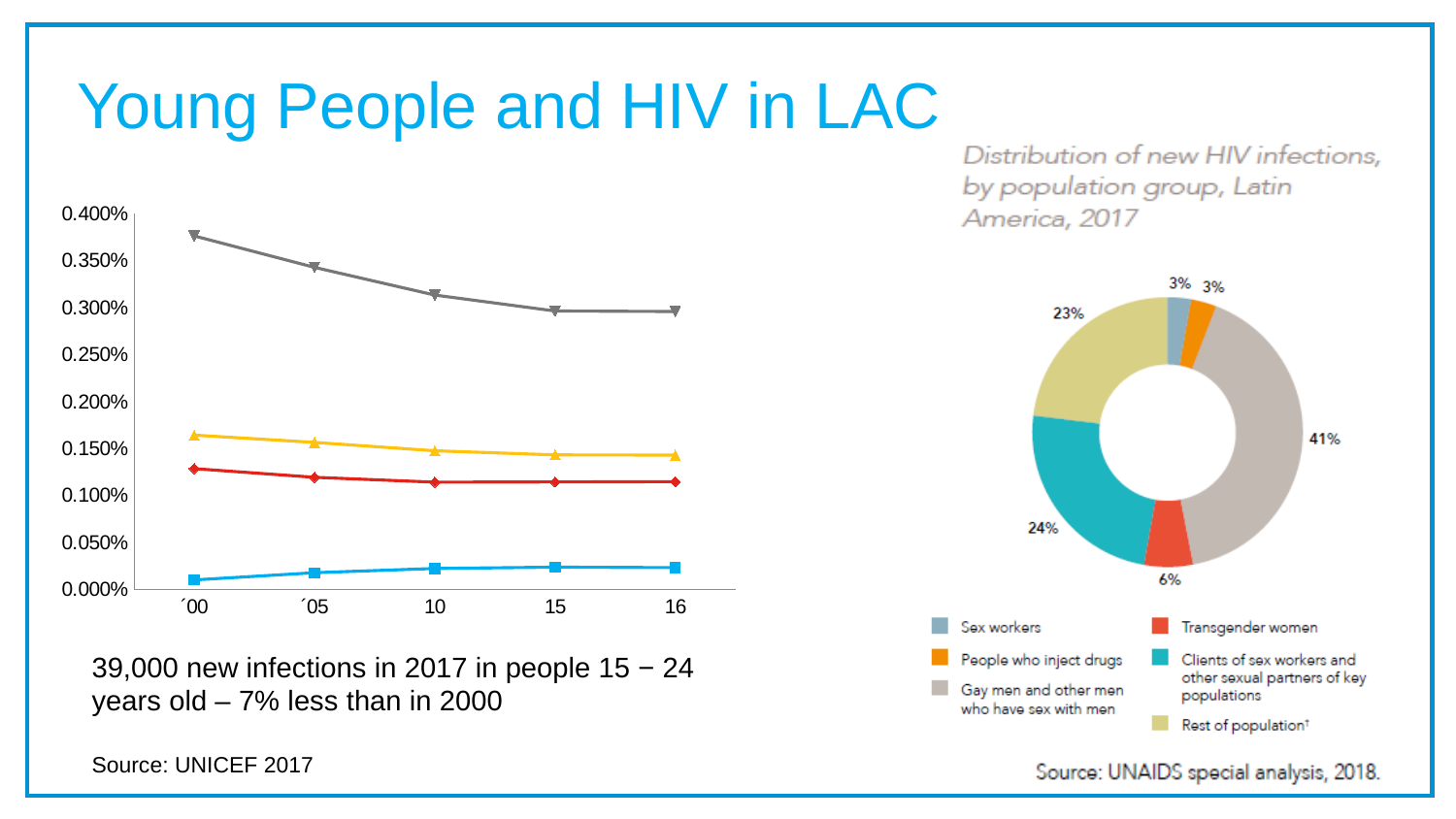
In the chart titled 'Distribution of new HIV infections, by population group, Latin America, 2017', which is larger: the share for clients of sex workers and other sexual partners of key populations or the share for the rest of population? Clients of sex workers and other sexual partners of key populations What kind of chart is the one on the left side of the slide? Line chart In the chart titled 'Distribution of new HIV infections, by population group, Latin America, 2017', how many percentage points larger is the share for gay men and other men who have sex with men than for clients of sex workers and other sexual partners of key populations? 17 percentage points In the chart titled 'Distribution of new HIV infections, by population group, Latin America, 2017', which population group has the largest share? Gay men and other men who have sex with men In the line chart on the left side of the slide, how many points are labelled on the x axis? 5 In the chart titled 'Distribution of new HIV infections, by population group, Latin America, 2017', what share is attributed to transgender women? 6% In the chart titled 'Distribution of new HIV infections, by population group, Latin America, 2017', what share of new infections is attributed to gay men and other men who have sex with men? 41% In the chart titled 'Distribution of new HIV infections, by population group, Latin America, 2017', what share is attributed to the rest of population? 23% In the chart titled 'Distribution of new HIV infections, by population group, Latin America, 2017', how many population groups are listed in the legend? 6 What kind of chart is the one titled 'Distribution of new HIV infections, by population group, Latin America, 2017'? Pie (donut) chart In the chart titled 'Distribution of new HIV infections, by population group, Latin America, 2017', what share is attributed to clients of sex workers and other sexual partners of key populations? 24% In the line chart on the left side of the slide, does the top (grey) line rise or fall from '00 to 16? Fall